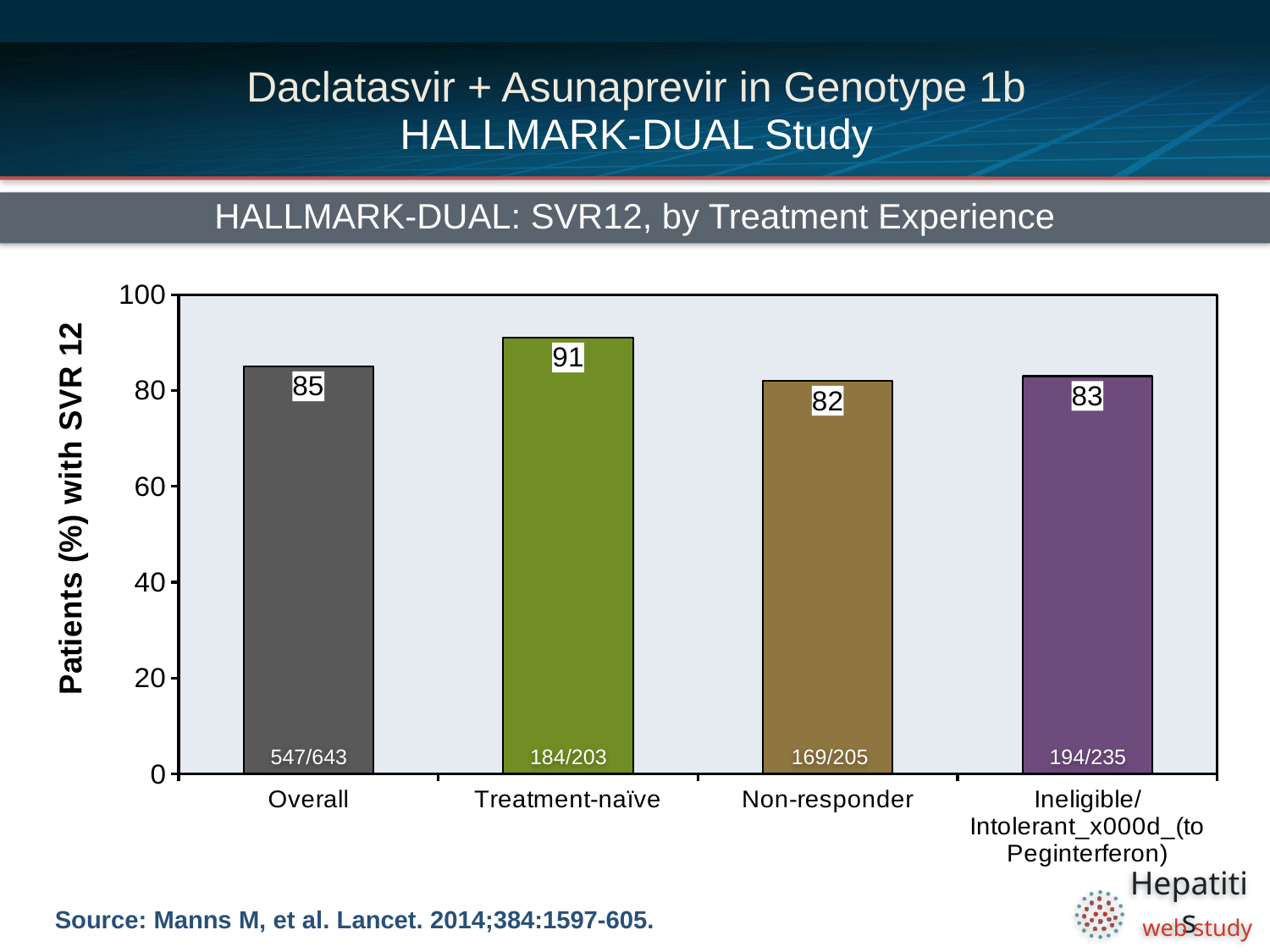
What is the SVR12 value for the Overall group? 85 What kind of chart is shown on the slide? Bar chart What is the label of the y axis? Patients (%) with SVR 12 Which group has the lowest SVR12 value? Non-responder How many groups are shown on the x axis? 4 What fraction of patients is shown at the base of the Non-responder bar? 169/205 Which is larger, the SVR12 value for Overall or for Treatment-naïve? Treatment-naïve What is the SVR12 value for the Non-responder group? 82 What is the difference between the Treatment-naïve and Non-responder SVR12 values? 9 What is the SVR12 value for the Treatment-naïve group? 91 What fraction of patients is shown at the base of the Overall bar? 547/643 Which group has the highest SVR12 value? Treatment-naïve